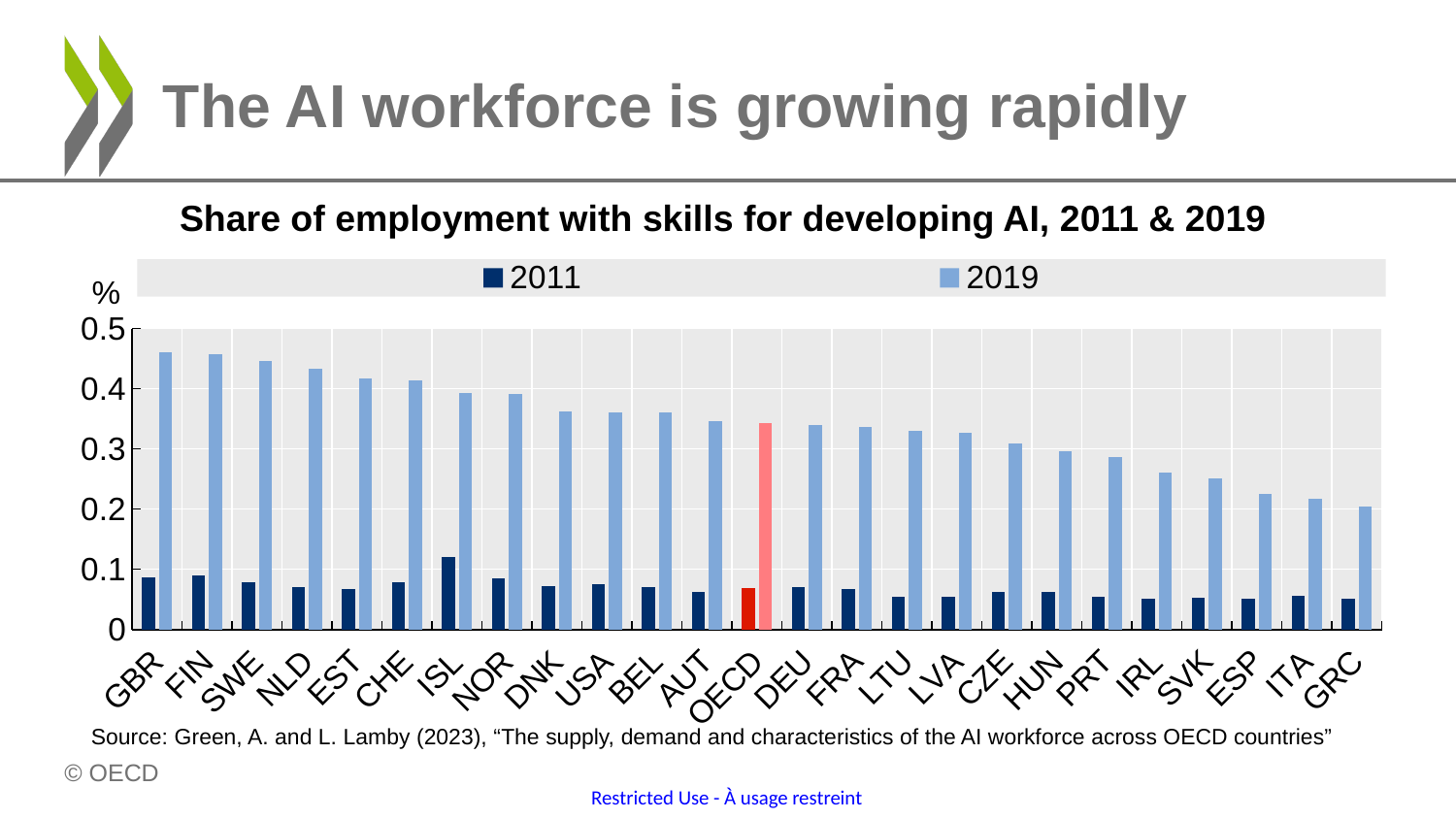
Which is larger for GBR: the 2011 value or the 2019 value? 2019 Is the 2019 value for OECD greater or less than 0.3? greater Which category's 2019 bar is highlighted in a different colour (red/pink) from the others? OECD Is the 2011 value for ISL greater or less than 0.1? greater How many countries/categories are shown on the x axis? 25 What is the title of the chart? Share of employment with skills for developing AI, 2011 & 2019 Which category has the highest value for 2011? ISL What kind of chart is shown on the slide? Bar chart Is the 2019 value for GRC greater or less than 0.3? less How many series does the legend list? 2 Do the 2019 values rise or fall moving from left to right along the x axis? fall